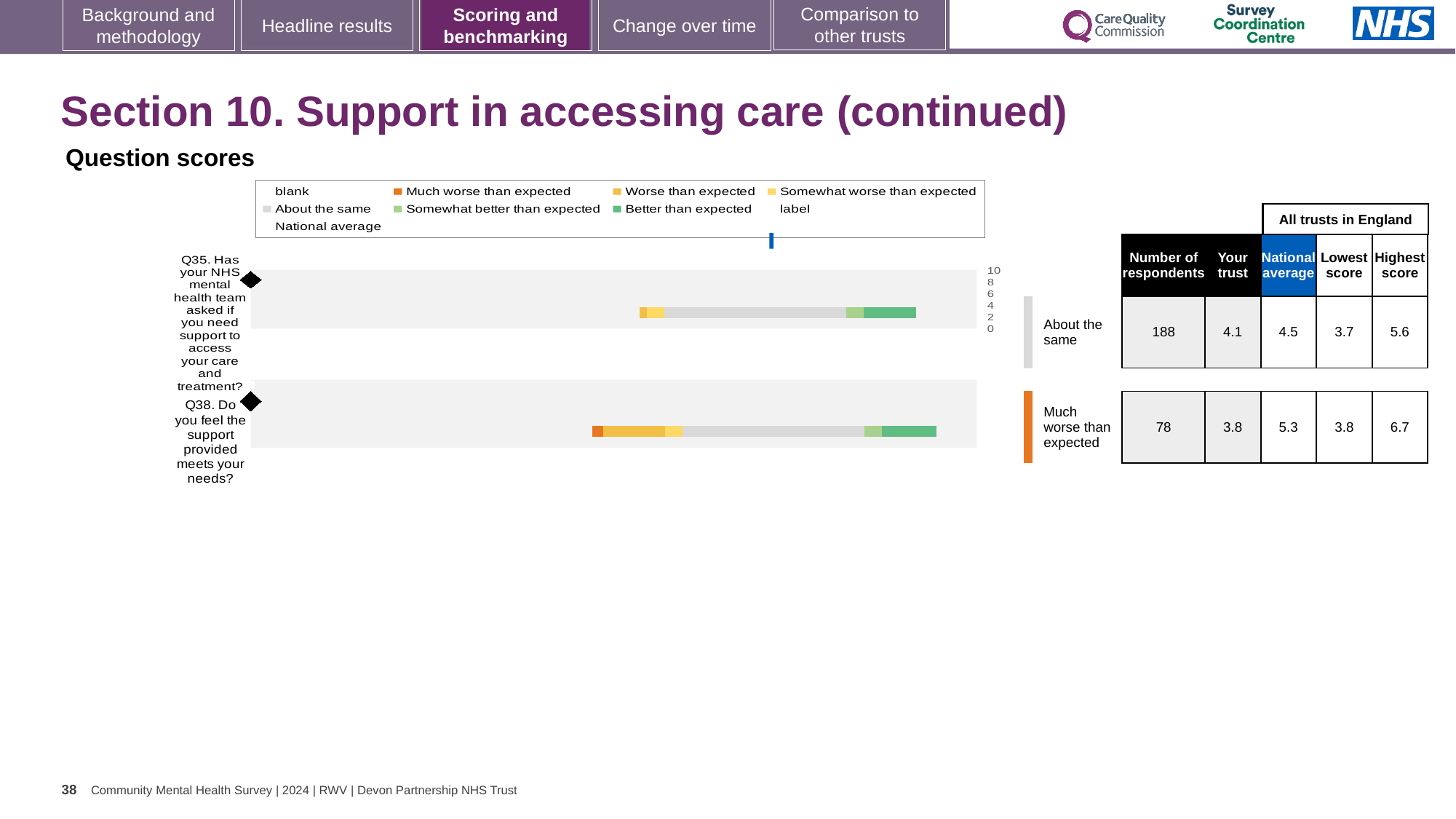
Which question has the higher 'Your trust' score, Q35 or Q38? Q35 Which benchmark category is Q35 placed in? About the same What is the 'Your trust' score for Q38 (Do you feel the support provided meets your needs?)? 3.8 What type of chart is used to show the question scores on this slide? bar chart What is the difference between the highest and lowest scores across all trusts in England for Q38? 2.9 What is the 'Your trust' score for Q35 (Has your NHS mental health team asked if you need support to access your care and treatment?)? 4.1 How many questions are plotted in the question scores chart? 2 What is the difference between the national average and the 'Your trust' score for Q38? 1.5 What is the national average score for Q38? 5.3 How many respondents answered Q35? 188 What is the highest score across all trusts in England for Q35? 5.6 Which benchmark category is Q38 placed in? Much worse than expected